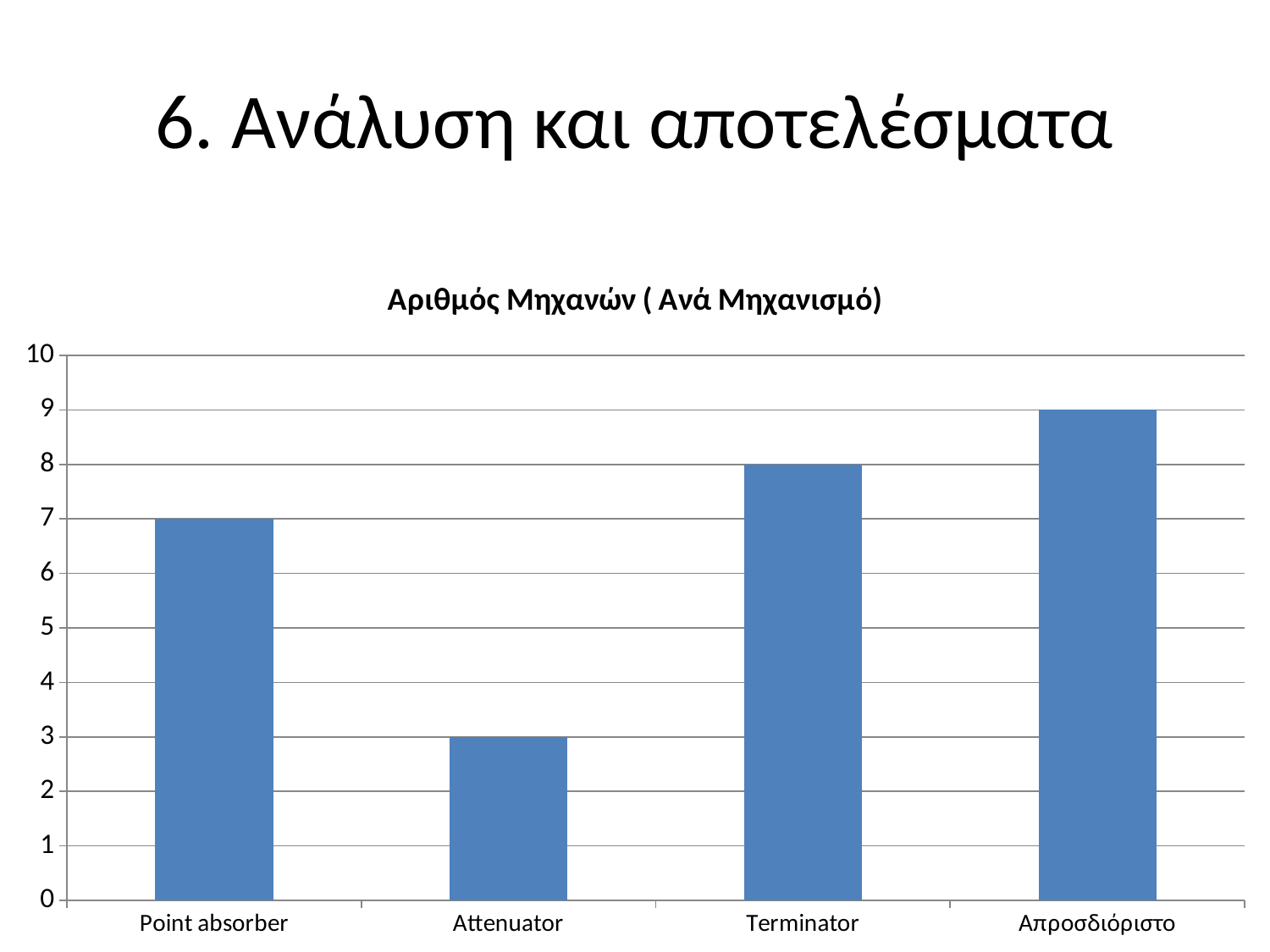
Which category has the lowest value? Attenuator What is the value for Απροσδιόριστο? 9 Which category has the highest value? Απροσδιόριστο What kind of chart is shown on the slide? bar chart What is the difference between the values for Απροσδιόριστο and Attenuator? 6 Which is larger, the value for Point absorber or the value for Terminator? Terminator Is the value for Attenuator greater or less than 5? less What is the value for Attenuator? 3 What is the value for Point absorber? 7 What is the title of the chart? Αριθμός Μηχανών ( Ανά Μηχανισμό) What is the value for Terminator? 8 How many categories are shown on the x axis? 4